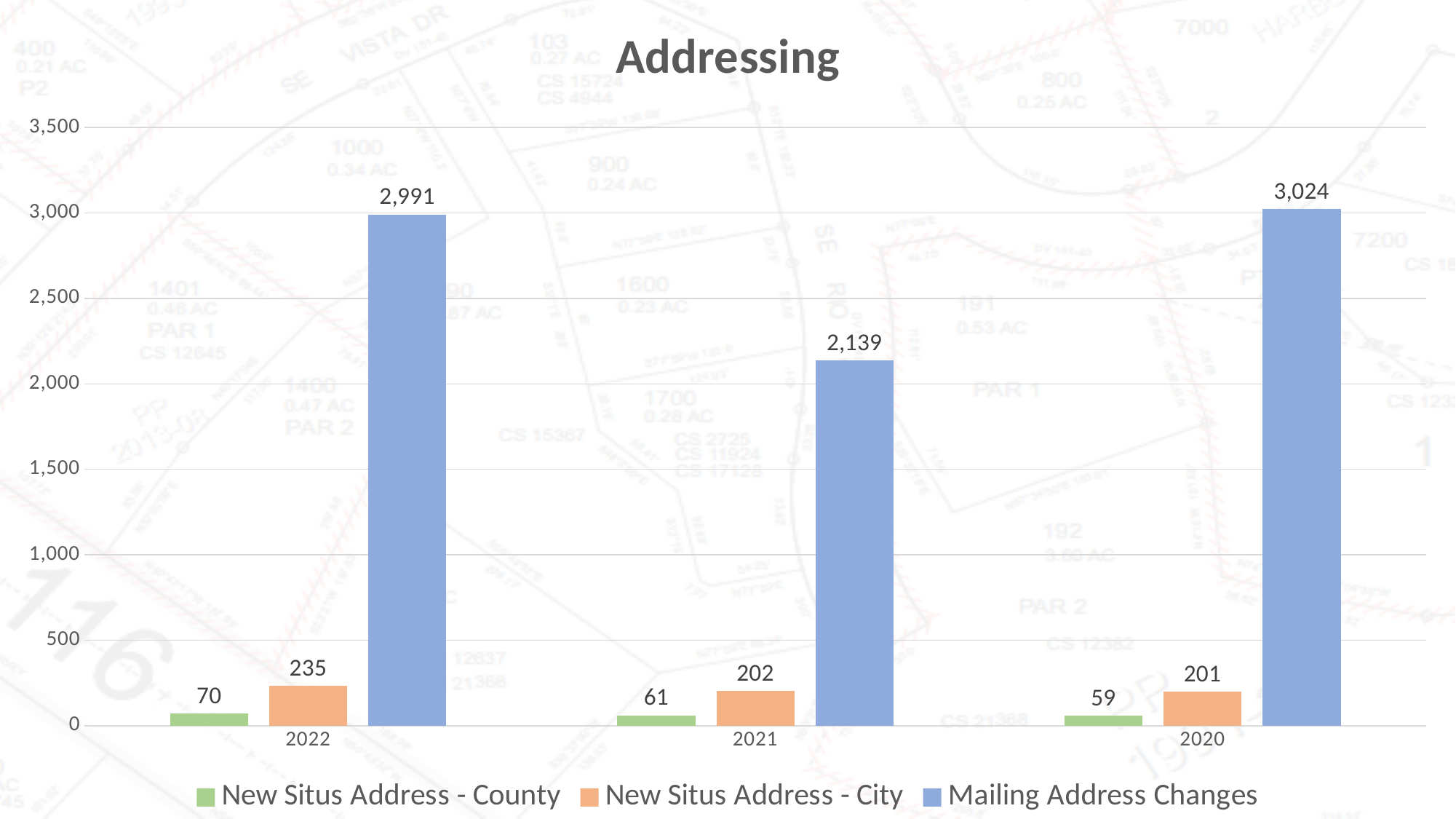
What is the title of the chart? Addressing Is the value for Mailing Address Changes in 2021 greater or less than 2,500? less What is the difference between Mailing Address Changes in 2020 and in 2021? 885 Which year has the highest value for Mailing Address Changes? 2020 What is the value for New Situs Address - County in 2021? 61 Which year has the lowest value for New Situs Address - County? 2020 What is the value for Mailing Address Changes in 2022? 2,991 How many years are shown on the x axis? 3 What kind of chart is shown on the slide? bar chart How many series does the legend list? 3 What is the value for New Situs Address - City in 2020? 201 Which is larger: New Situs Address - City in 2022 or in 2021? 2022